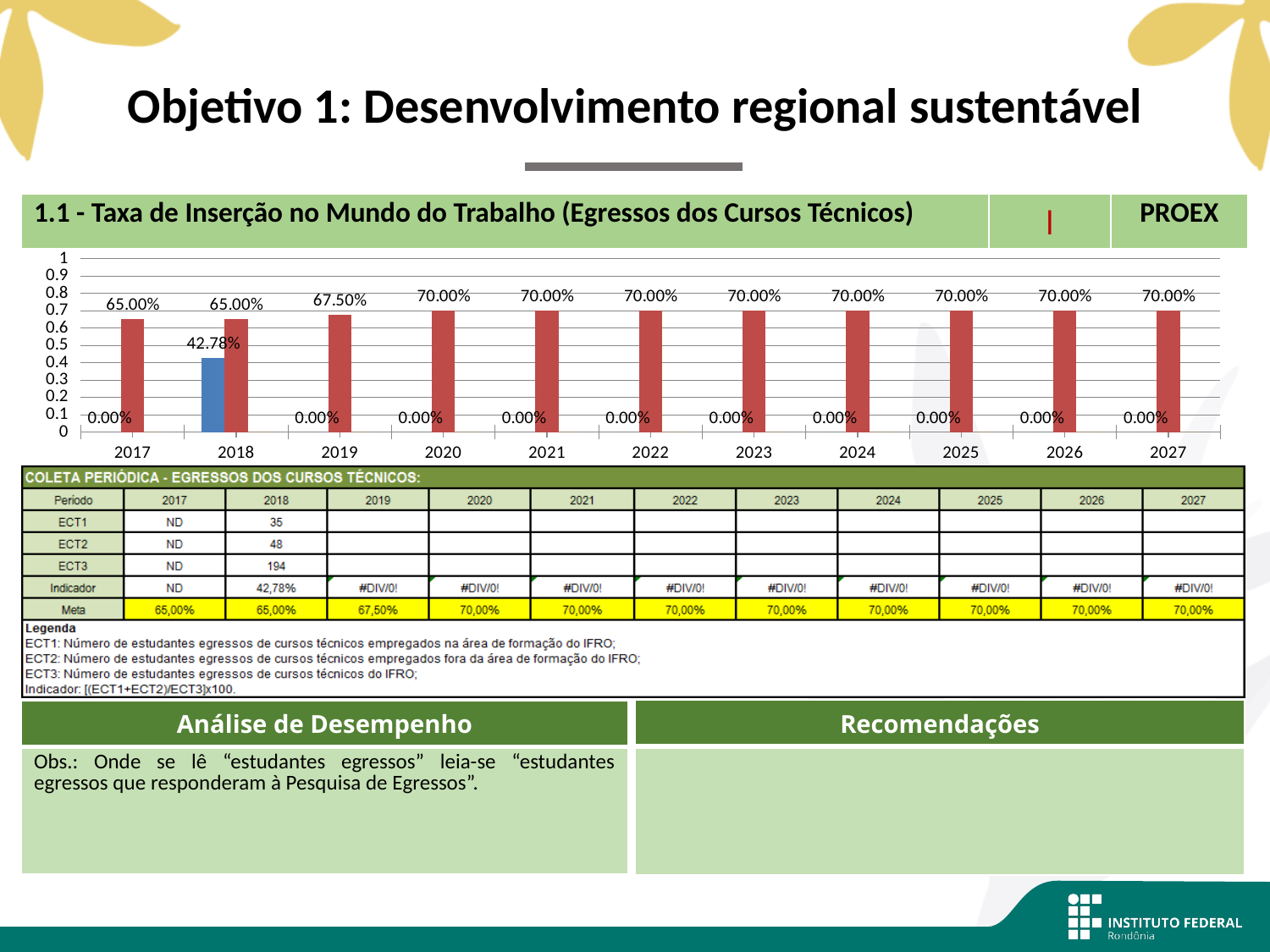
Do the red bar values rise or fall from 2017 to 2020? rise Which is larger in 2018, the red bar or the blue bar? the red bar Which year has the lowest red bar value? 2017 and 2018 What is the difference between the red bar and the blue bar in 2018? 22.22% What type of chart is shown on the slide? bar chart What is the difference between the red bar values for 2020 and 2019? 2.50% What is the value of the red bar for 2017? 65.00% What is the value of the red bar for 2025? 70.00% What is the value of the blue bar for 2018? 42.78% What is the value of the red bar for 2019? 67.50% What is the value of the blue bar for 2022? 0.00% How many years are shown on the x axis of the chart? 11